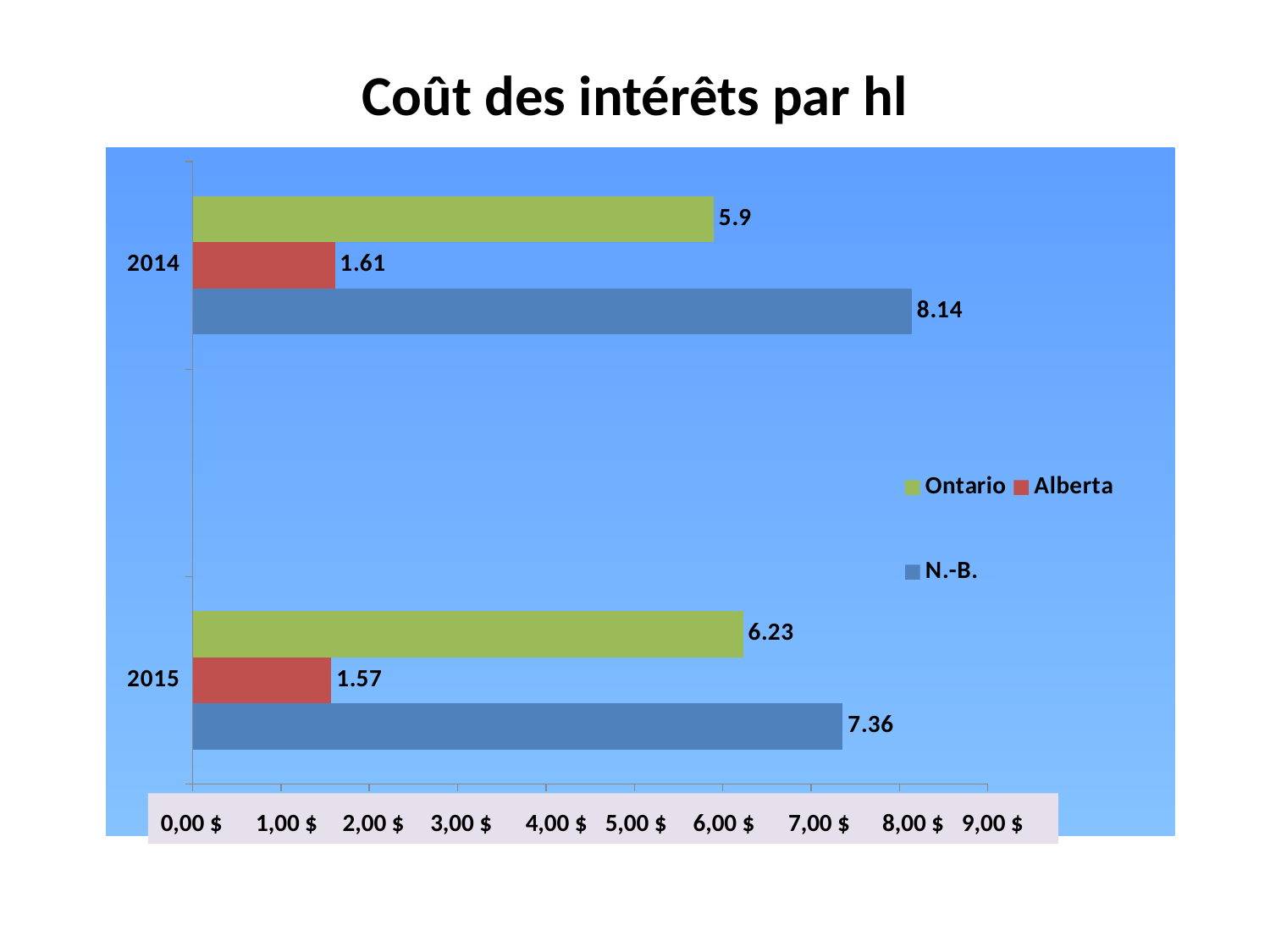
What is the value for Alberta in 2015? 1.57 How many year categories are shown on the chart? 2 Which series has the highest value in 2015? N.-B. What is the difference between the N.-B. values for 2014 and 2015? 0.78 What is the title of the chart? Coût des intérêts par hl What kind of chart is shown on the slide? bar chart Is the value for N.-B. in 2015 greater or less than 7,00 $? greater Which series has the lowest value in 2014? Alberta Which is larger, the Ontario value in 2015 or the Ontario value in 2014? Ontario in 2015 What is the value for N.-B. in 2014? 8.14 What is the value for Ontario in 2014? 5.9 How many series does the legend list? 3